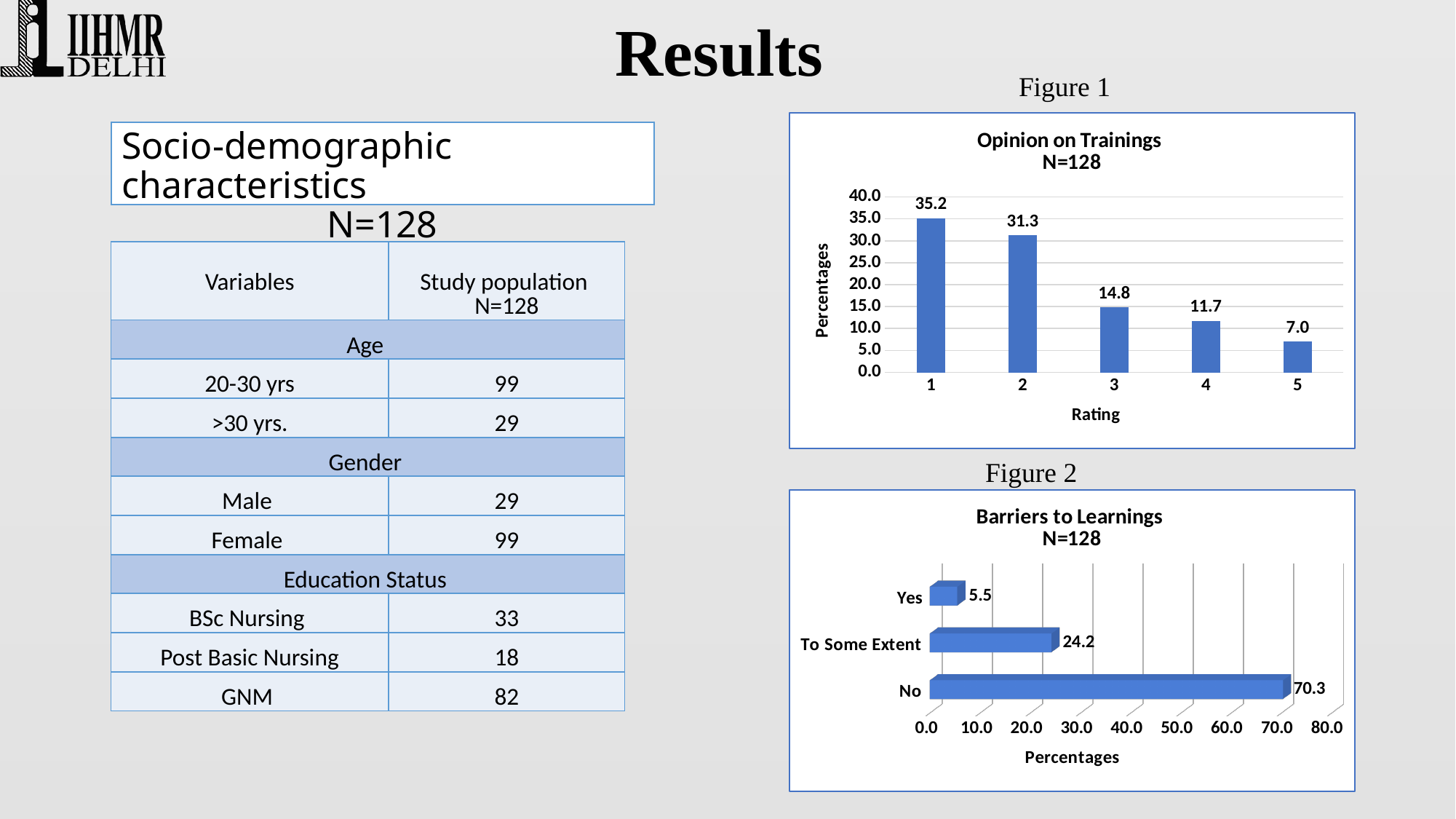
In the 'Opinion on Trainings' chart, do the values rise or fall as the rating increases from 1 to 5? fall What kind of chart is the 'Barriers to Learnings' chart? bar chart In the 'Opinion on Trainings' chart, what is the value for rating 1? 35.2 In the 'Opinion on Trainings' chart, which rating has the highest percentage? 1 How many rating categories are shown in the 'Opinion on Trainings' chart? 5 In the 'Opinion on Trainings' chart, which rating has the lowest percentage? 5 In the 'Opinion on Trainings' chart, what is the difference between the values for rating 2 and rating 4? 19.6 In the 'Barriers to Learnings' chart, what is the value for 'To Some Extent'? 24.2 In the 'Barriers to Learnings' chart, which category has the highest percentage? No In the 'Opinion on Trainings' chart, what is the value for rating 3? 14.8 In the 'Barriers to Learnings' chart, which is larger, the value for 'Yes' or the value for 'To Some Extent'? To Some Extent In the 'Barriers to Learnings' chart, what is the difference between the values for 'No' and 'Yes'? 64.8